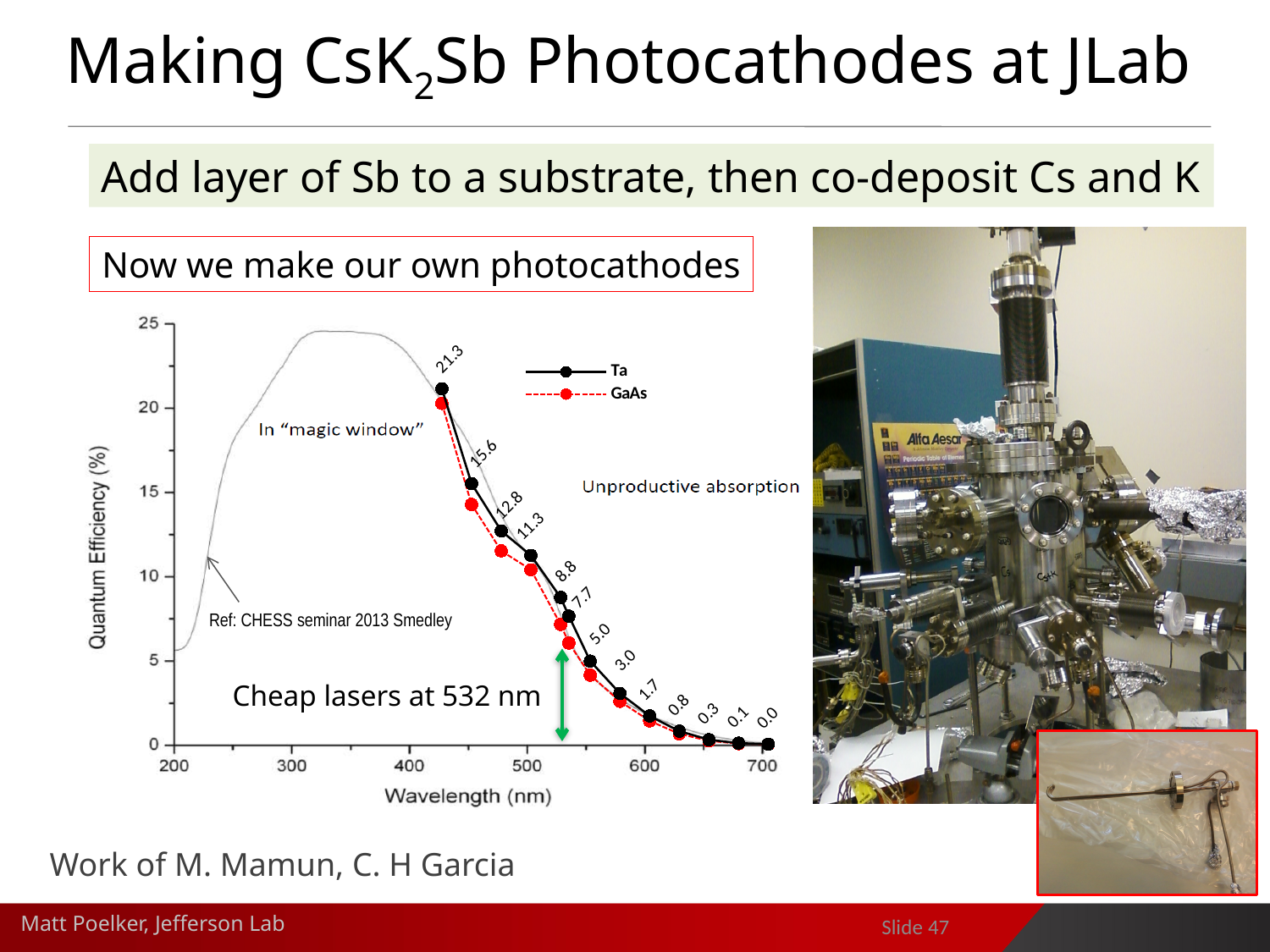
How many data labels are printed along the curve? 13 Does the quantum efficiency rise or fall as wavelength increases from 400 nm to 700 nm? fall Is the quantum efficiency at 600 nm greater or less than 5? less How many series does the chart legend list? 2 What kind of chart is shown on the slide? line chart What is the highest data label printed on the chart? 21.3 What is the difference between the first two data labels, 21.3 and 15.6? 5.7 What are the two series named in the chart legend? Ta and GaAs What is the lowest data label printed on the chart? 0.0 At around 450 nm, which series has the higher quantum efficiency, Ta or GaAs? Ta Is the quantum efficiency of the first labelled point (near 425 nm) greater or less than 20? greater What is the label of the chart's y axis? Quantum Efficiency (%)